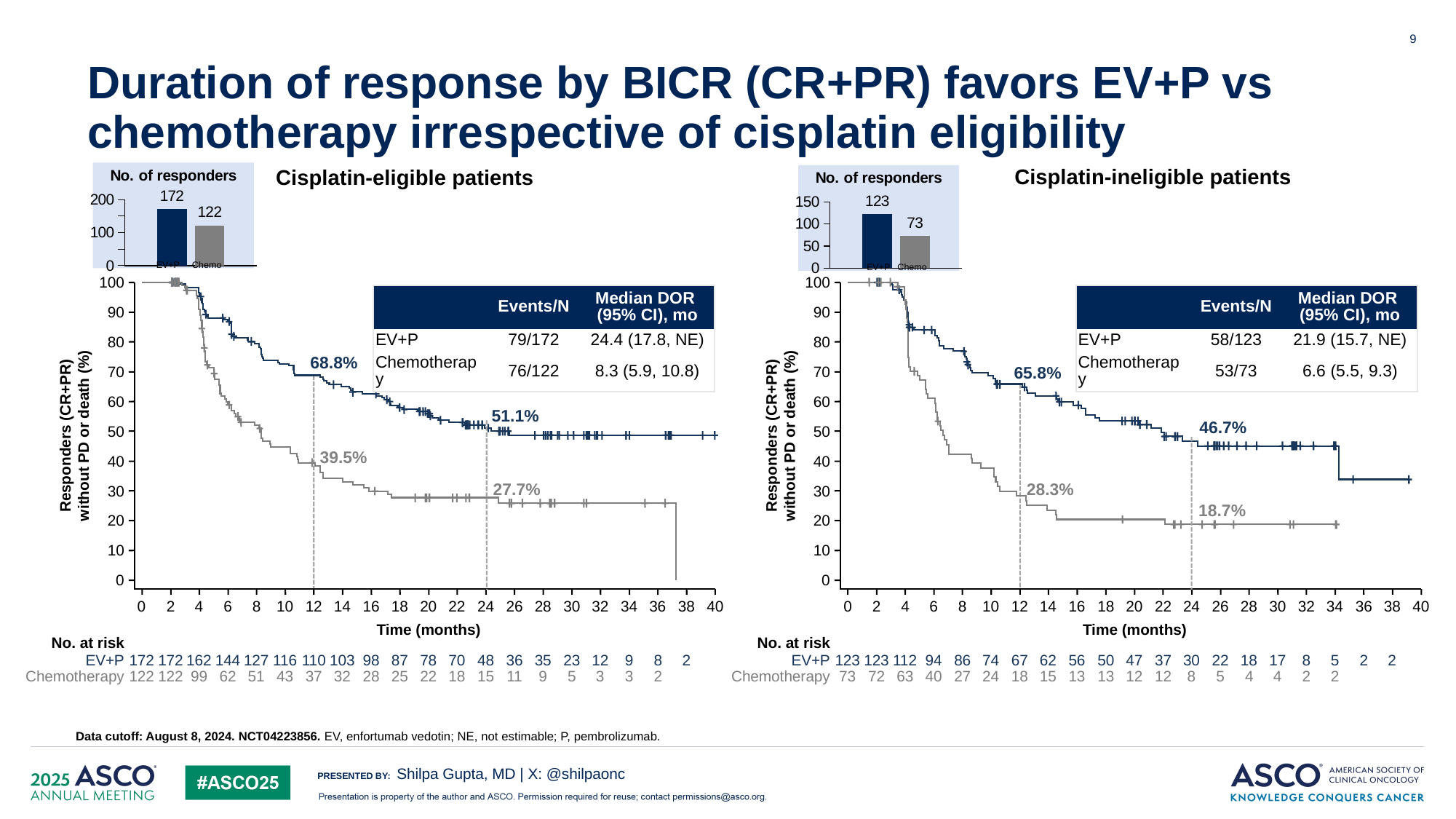
In the cisplatin-ineligible patients curve chart, what is the difference between the EV+P and chemotherapy labeled values at 12 months? 37.5 percentage points In the "No. of responders" bar chart for cisplatin-eligible patients, what is the difference between the EV+P and Chemo bars? 50 In the "No. of responders" bar chart for cisplatin-ineligible patients, which bar is higher, EV+P or Chemo? EV+P What kind of chart is the "No. of responders" inset on the cisplatin-eligible side? Bar chart How many bars are in the "No. of responders" chart for cisplatin-ineligible patients? 2 In the "No. of responders" bar chart for cisplatin-eligible patients, what is the value for EV+P? 172 In the cisplatin-eligible patients curve chart, which curve has the higher labeled value at 24 months, EV+P or chemotherapy? EV+P In the cisplatin-eligible patients curve chart, what percentage is labeled for chemotherapy at 24 months? 27.7% In the cisplatin-eligible patients curve chart, what percentage is labeled for EV+P at 12 months? 68.8% In the cisplatin-ineligible patients curve chart, what percentage is labeled for EV+P at 24 months? 46.7% In the "No. of responders" bar chart for cisplatin-ineligible patients, what is the value for Chemo? 73 In the cisplatin-ineligible patients curve chart, do the curves rise or fall as time in months increases? Fall